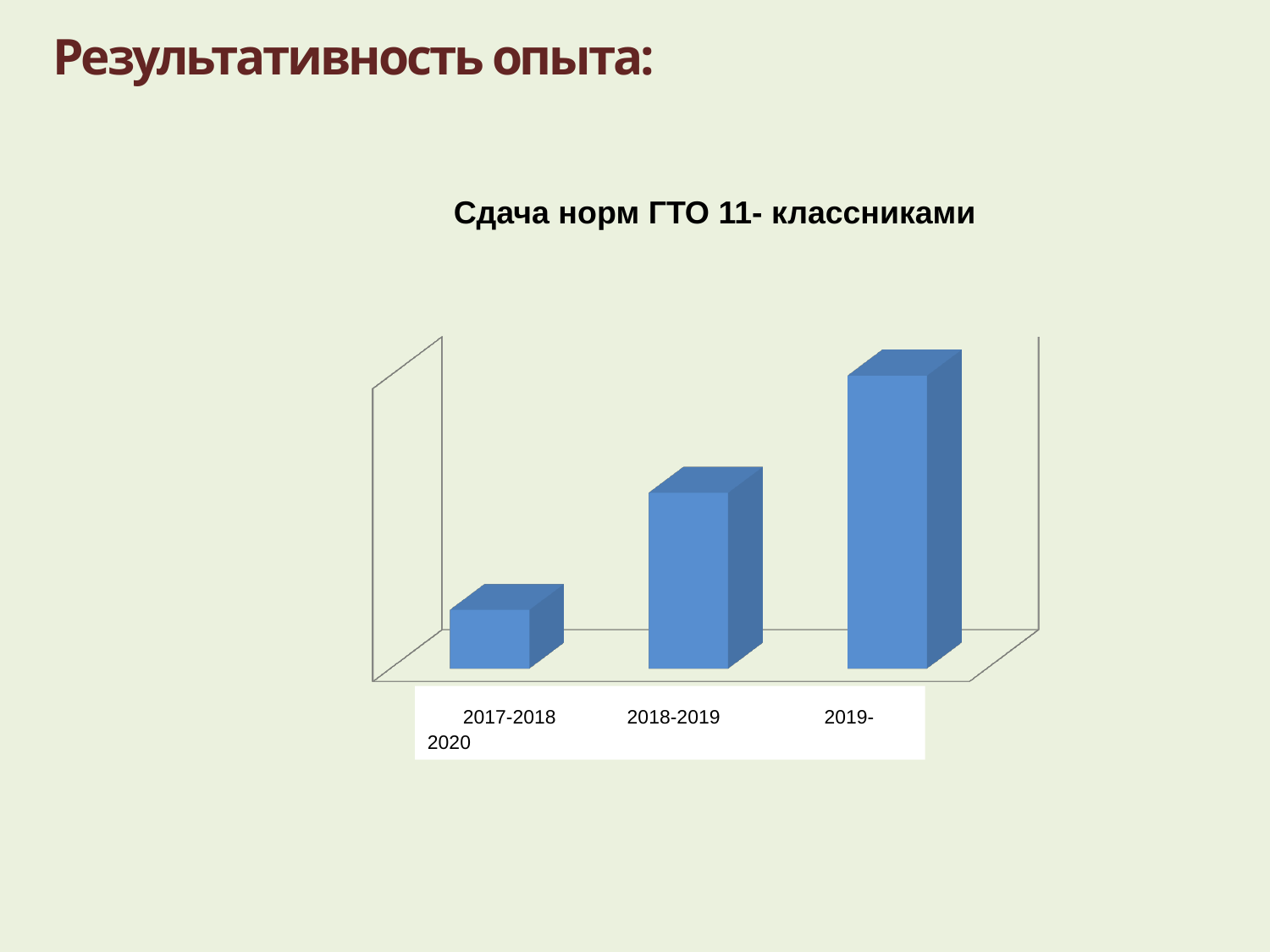
Which is larger, the bar for 2018-2019 or the bar for 2017-2018? 2018-2019 How many categories are shown on the x axis of the chart? 3 What is the label of the first category on the x axis? 2017-2018 What kind of chart is shown on the slide? bar chart Which category has the lowest bar in the chart? 2017-2018 Which category has the highest bar in the chart? 2019-2020 Do the values rise or fall from 2017-2018 to 2019-2020? rise Which is larger, the bar for 2019-2020 or the bar for 2018-2019? 2019-2020 What is the title of the chart? Сдача норм ГТО 11- классниками What colour are the bars in the chart? blue